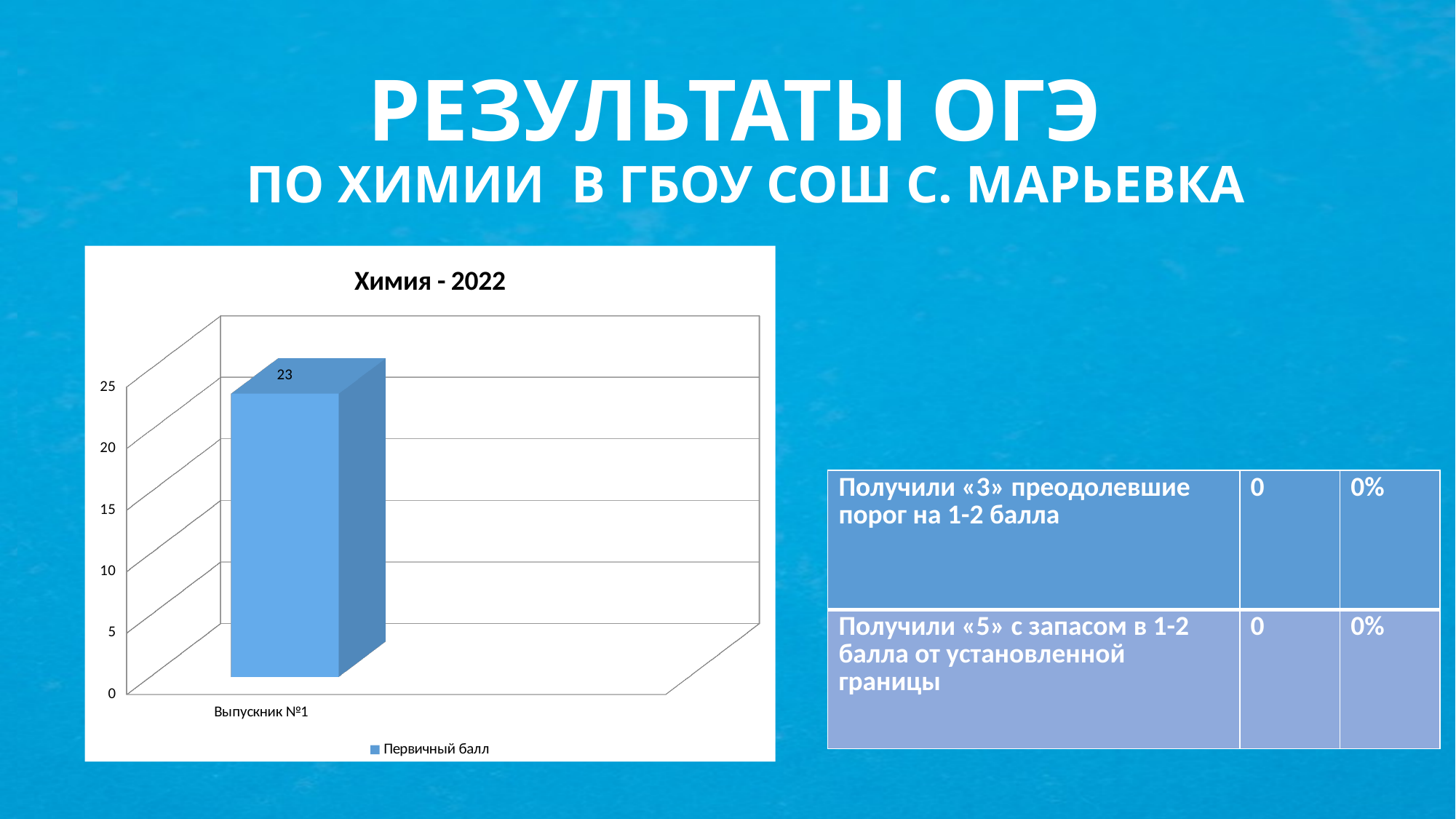
What is the highest value shown on the vertical axis of the chart? 25 Is the value for Выпускник №1 greater or less than 20? greater What series name is shown in the chart legend? Первичный балл What is the value for Выпускник №1 in the chart? 23 Is the value for Выпускник №1 greater or less than 25? less What kind of chart is shown on the slide? bar chart How many categories are plotted in the chart? 1 What is the title of the chart? Химия - 2022 How many series does the chart legend list? 1